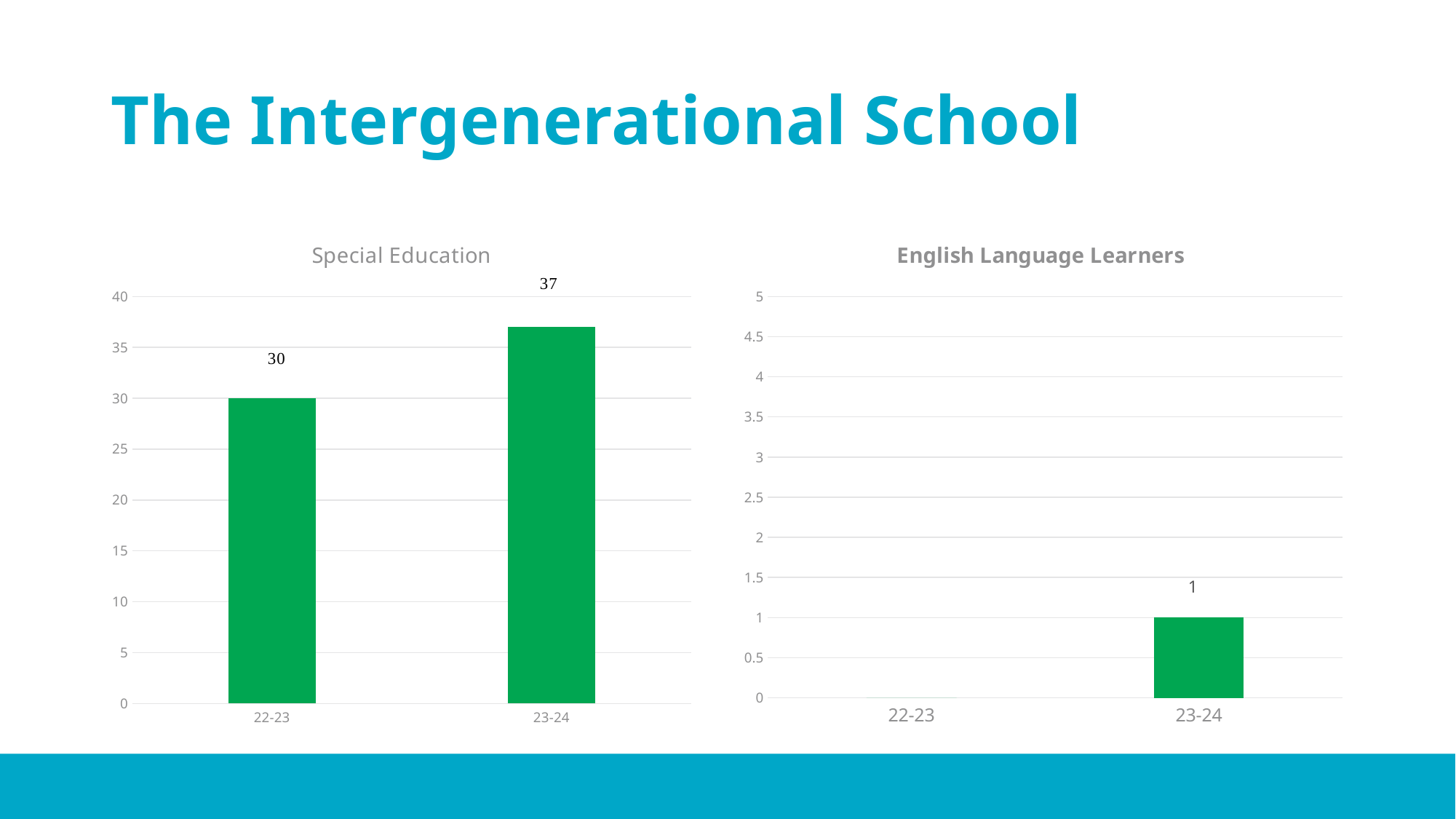
In the Special Education chart, do the values rise or fall from 22-23 to 23-24? rise In the Special Education chart, what is the value for 22-23? 30 What kind of chart is the Special Education chart? bar chart In the English Language Learners chart, what is the value for 23-24? 1 What is the title of the chart on the right side of the slide? English Language Learners In the Special Education chart, which year has the lower value? 22-23 In the Special Education chart, which year has the higher value? 23-24 In the Special Education chart, is the value for 23-24 greater or less than 35? greater How many categories are shown on the x axis of the English Language Learners chart? 2 In the Special Education chart, what is the difference between the 23-24 and 22-23 values? 7 In the English Language Learners chart, which year has the higher value? 23-24 In the Special Education chart, what is the value for 23-24? 37